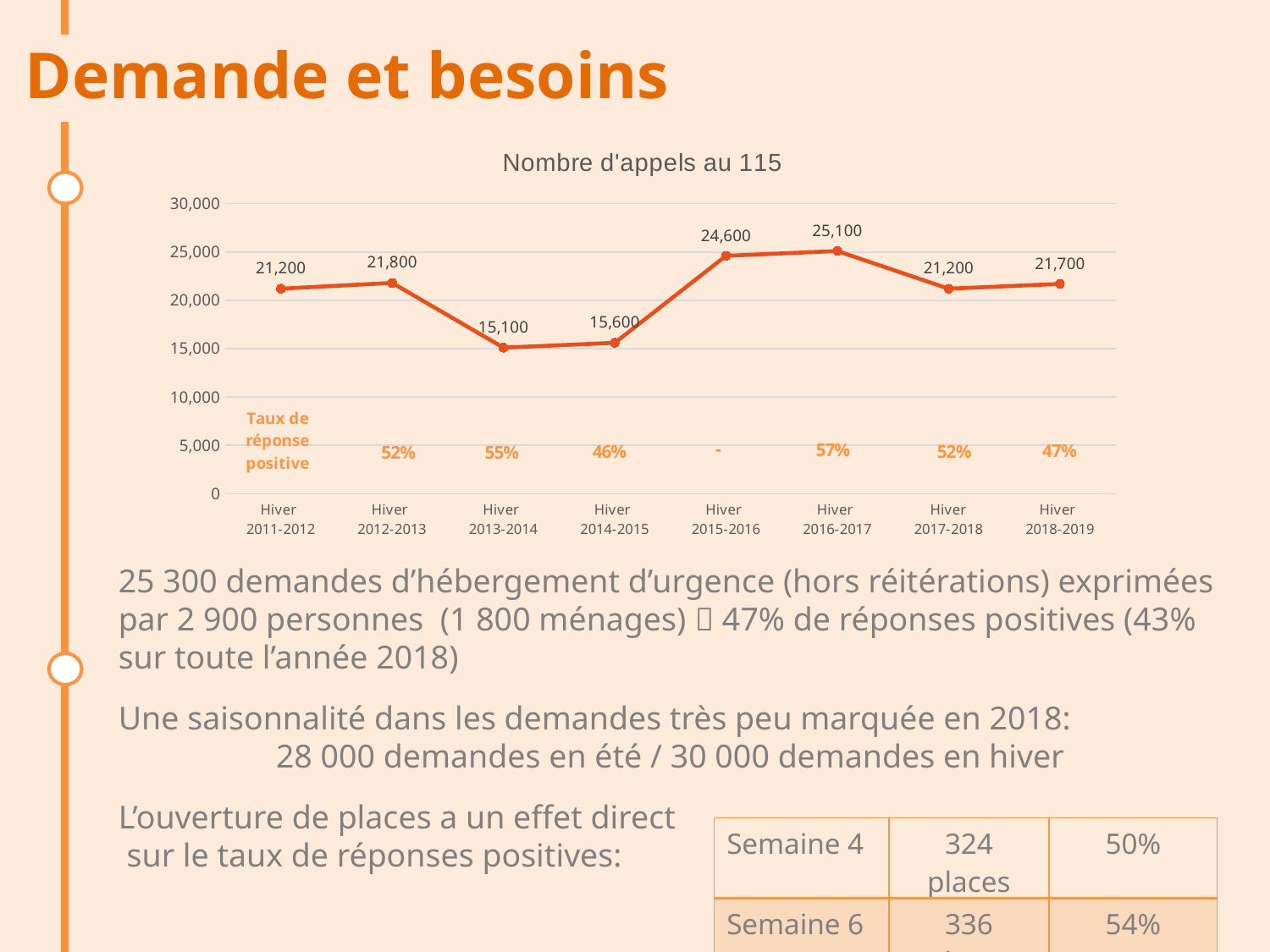
What is the title of the chart? Nombre d'appels au 115 Which winter has the highest number of calls? Hiver 2016-2017 What is the number of calls for Hiver 2016-2017? 25,100 What is the number of calls for Hiver 2013-2014? 15,100 Which has more calls, Hiver 2012-2013 or Hiver 2015-2016? Hiver 2015-2016 What is the 'Taux de réponse positive' shown for Hiver 2016-2017? 57% Do the number of calls rise or fall from Hiver 2014-2015 to Hiver 2015-2016? rise How many winters (categories) are plotted on the x axis? 8 What is the difference in calls between Hiver 2016-2017 and Hiver 2013-2014? 10,000 Which winter has the lowest number of calls? Hiver 2013-2014 What is the number of calls for Hiver 2018-2019? 21,700 What kind of chart is shown on the slide? line chart